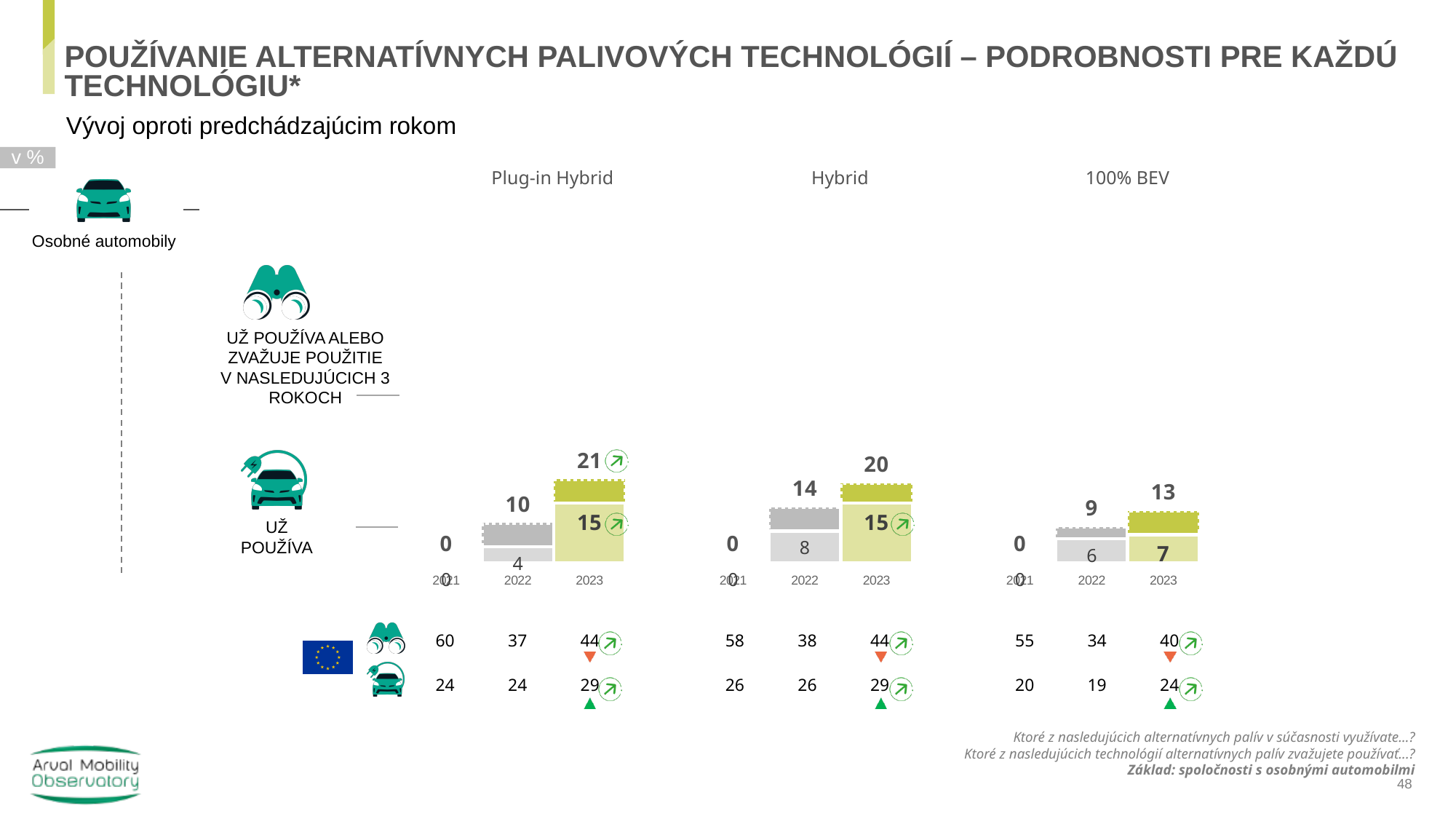
In the Plug-in Hybrid chart, does the 'Už používa' value rise or fall from 2021 to 2023? rise In the Hybrid chart, what is the difference between the 2023 and 2022 values for 'Už používa alebo zvažuje použitie v nasledujúcich 3 rokoch'? 6 What type of chart is used for the Hybrid data? bar chart In the Plug-in Hybrid chart, what is the difference between the 2023 and 2022 values for 'Už používa'? 11 How many years are shown on the x axis of the 100% BEV chart? 3 In the Hybrid chart, what is the value for 'Už používa' in 2023? 15 In the Plug-in Hybrid chart, what is the value for 'Už používa alebo zvažuje použitie v nasledujúcich 3 rokoch' in 2023? 21 In the Plug-in Hybrid chart, what is the value for 'Už používa' in 2022? 4 In the 100% BEV chart, what is the value for 'Už používa alebo zvažuje použitie v nasledujúcich 3 rokoch' in 2022? 9 In the Hybrid chart, which year has the highest value for 'Už používa alebo zvažuje použitie v nasledujúcich 3 rokoch'? 2023 Is the 2023 'Už používa' value larger in the Hybrid chart or in the 100% BEV chart? Hybrid In the 100% BEV chart, which year has the lowest value for 'Už používa'? 2021